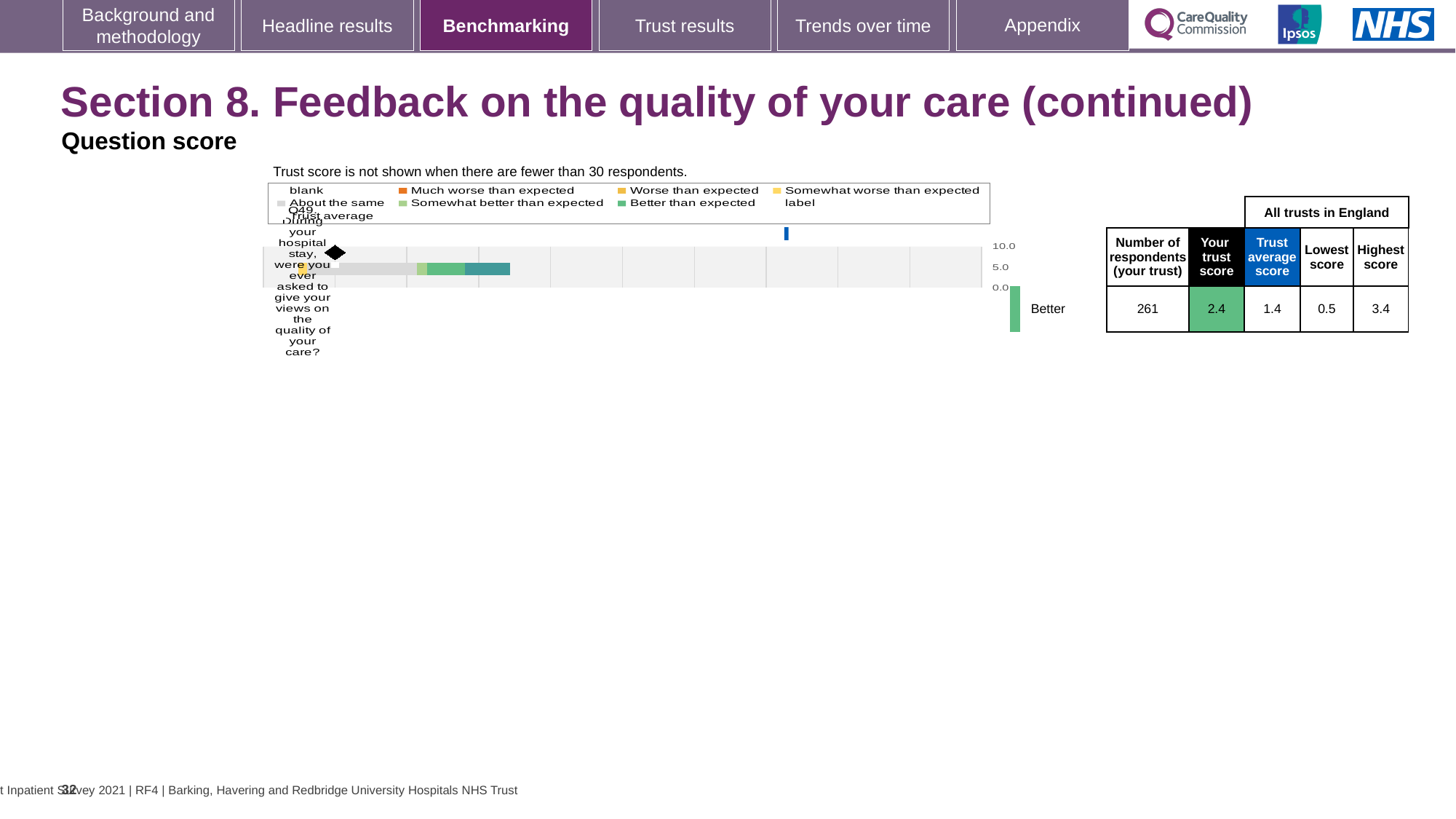
What is the Lowest score among all trusts in England for Q49? 0.5 How many questions are plotted in the chart? 1 Is Your trust score for Q49 greater or less than 5.0? less What is the difference between Your trust score and the Trust average score for Q49? 1.0 What benchmark category label is shown next to the green bar to the right of the chart? Better What is the Trust average score for Q49? 1.4 How many respondents from your trust answered Q49? 261 What is the difference between the Highest score and the Lowest score for Q49? 2.9 What kind of chart is shown on the slide? bar chart What is the trust score for Q49 (Your trust score)? 2.4 What is the Highest score among all trusts in England for Q49? 3.4 Which is larger for Q49: Your trust score or the Trust average score? Your trust score